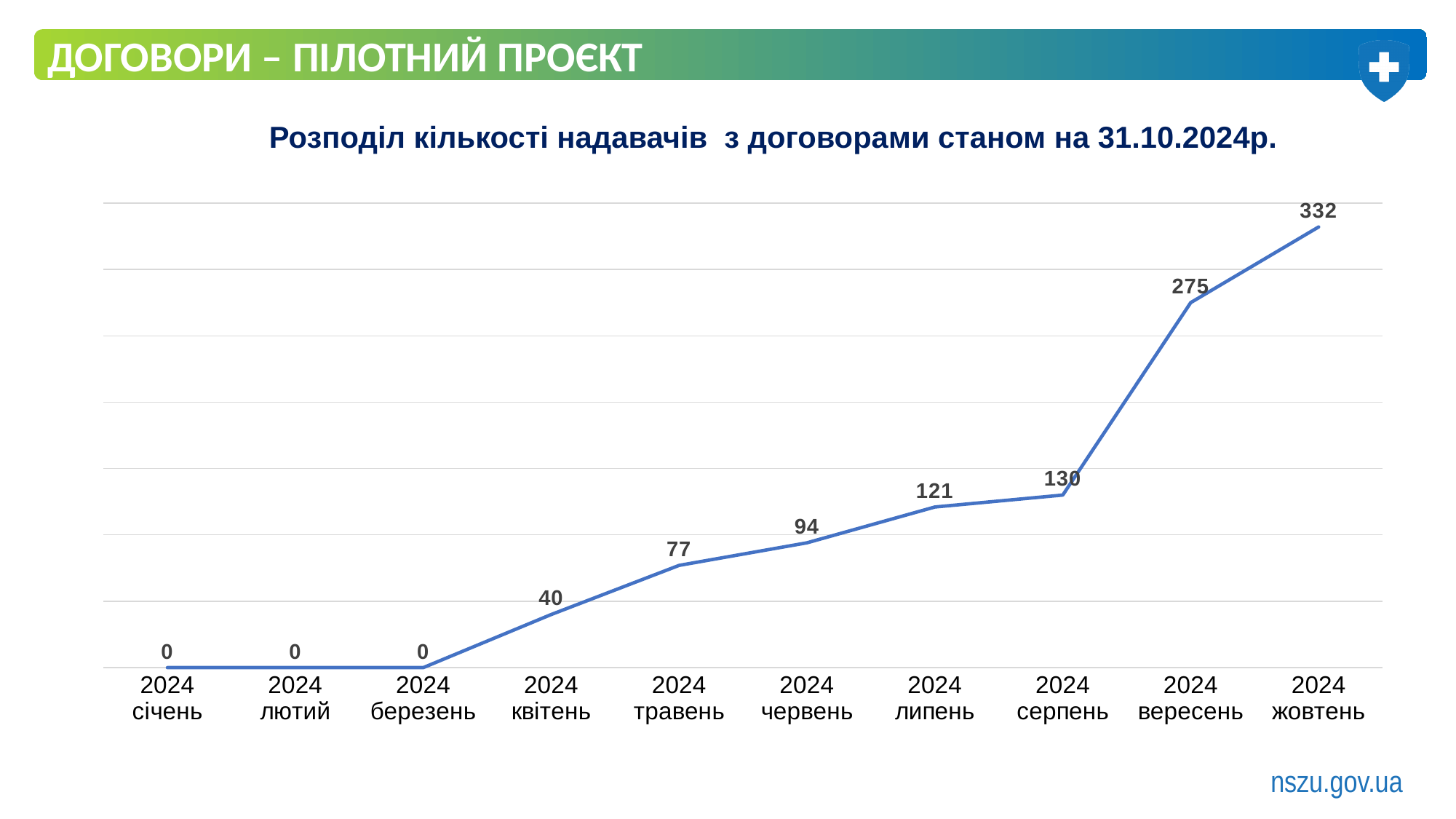
What is the value for 2024 жовтень? 332 How many months are plotted on the x axis? 10 What is the value for 2024 квітень? 40 How many months have a value of 0? 3 What kind of chart is this? line chart Which is larger, the value for 2024 травень or the value for 2024 червень? 2024 червень What is the value for 2024 вересень? 275 Which month has the highest value? 2024 жовтень What is the difference between the values for 2024 жовтень and 2024 вересень? 57 Do the values rise or fall from 2024 січень to 2024 жовтень? rise What is the difference between the values for 2024 серпень and 2024 липень? 9 What is the value for 2024 липень? 121